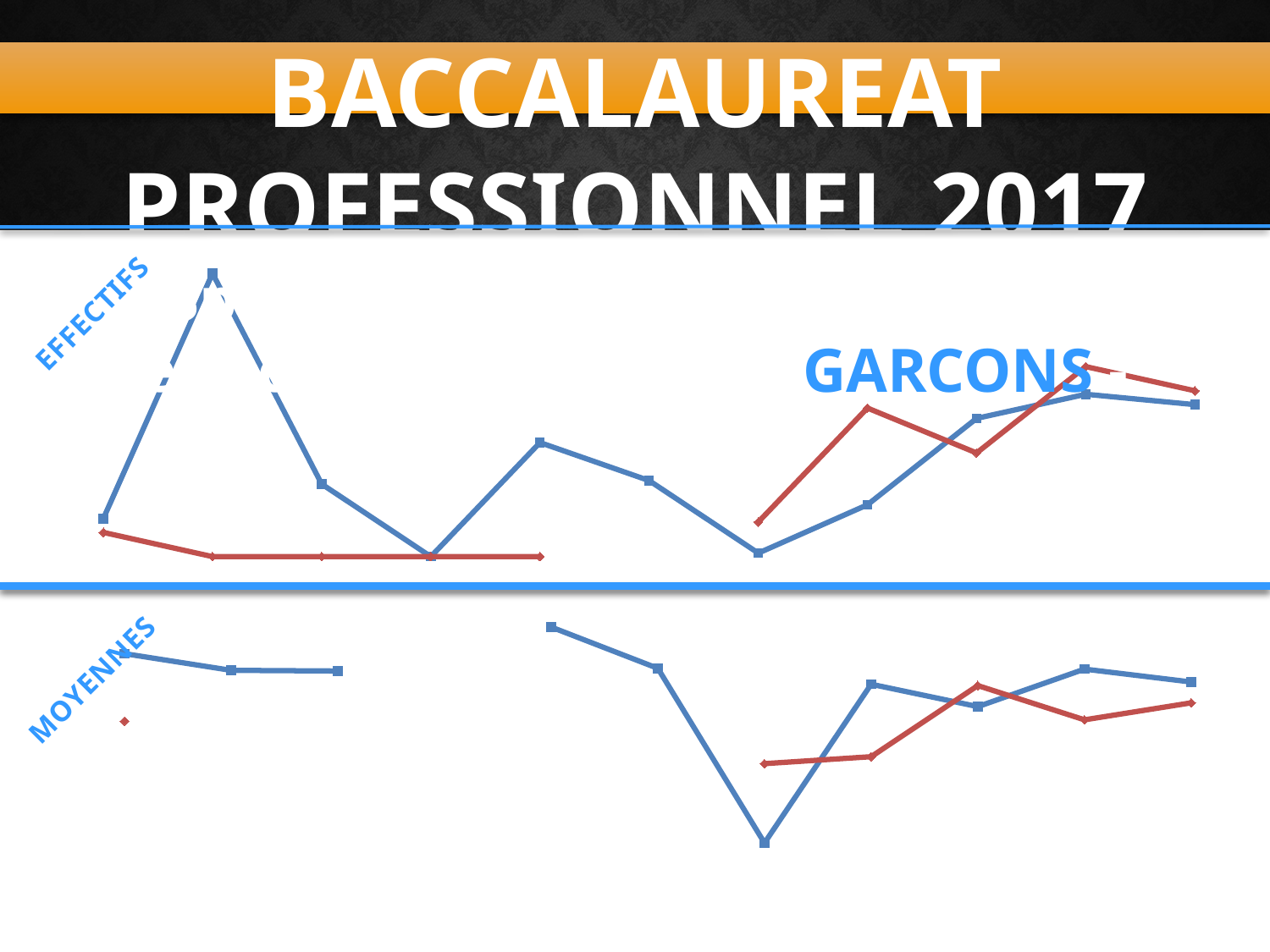
In the EFFECTIFS chart, is the blue line's second point higher or lower than its first point? higher In the MOYENNES chart, which line (by colour) reaches the lowest point? blue In the EFFECTIFS chart, does the red line rise or fall between its last two points? fall What label is written vertically beside the top chart? EFFECTIFS In the EFFECTIFS chart, which line (by colour) reaches the highest point? blue What kind of chart is the MOYENNES chart at the bottom of the slide? line chart How many lines are plotted in the MOYENNES chart? 2 What word is printed in large blue letters inside the top chart? GARCONS In the MOYENNES chart, does the blue line rise or fall between its first and second points? fall How many lines are plotted in the EFFECTIFS chart? 2 What kind of chart is the EFFECTIFS chart at the top of the slide? line chart